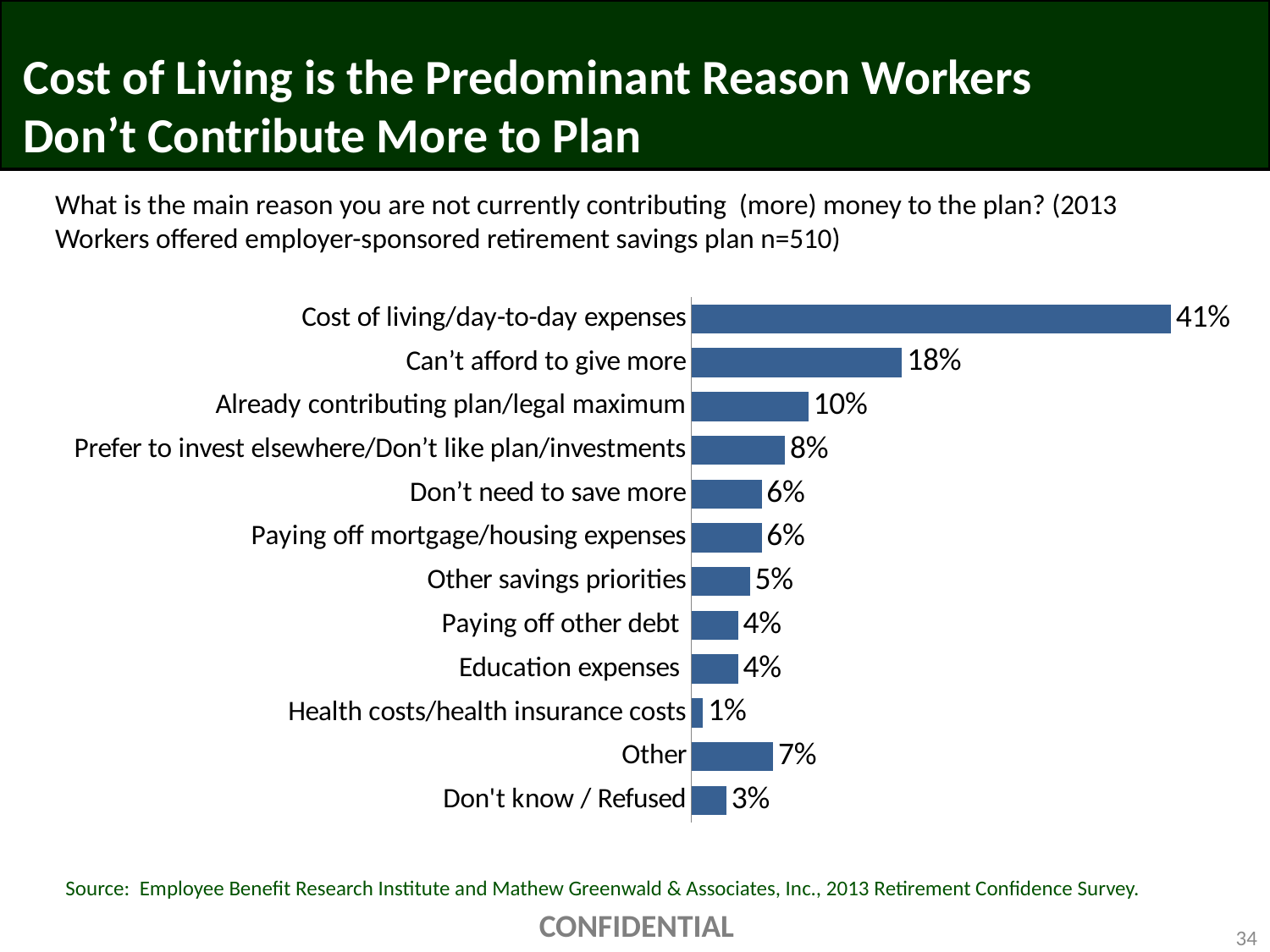
What percentage of workers cite cost of living/day-to-day expenses as the main reason for not contributing more? 41% What is the difference between "Cost of living/day-to-day expenses" and "Can't afford to give more"? 23 percentage points What is the value for "Health costs/health insurance costs"? 1% What is the value for "Already contributing plan/legal maximum"? 10% Which reason has the lowest percentage? Health costs/health insurance costs How many reasons (categories) are shown in the chart? 12 Which reason has the highest percentage? Cost of living/day-to-day expenses What is the difference between "Other" and "Other savings priorities"? 2 percentage points Which is larger: "Prefer to invest elsewhere/Don't like plan/investments" or "Don't need to save more"? Prefer to invest elsewhere/Don't like plan/investments What is the value for "Don't know / Refused"? 3% What type of chart is shown on the slide? Bar chart What is the sample size (n) stated in the question text above the chart? 510